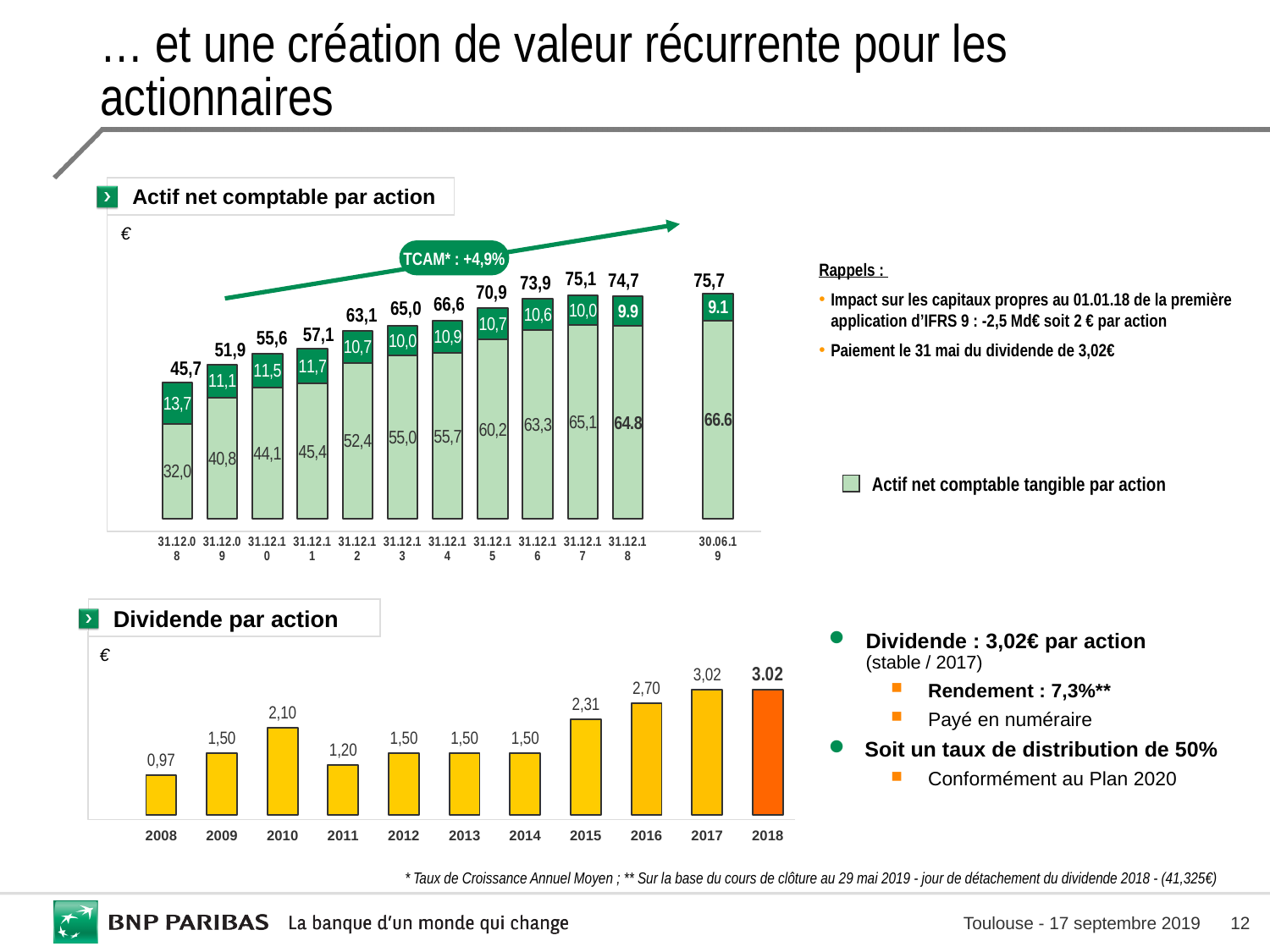
In the 'Actif net comptable par action' chart, which date has the highest total value? 30.06.19 In the 'Actif net comptable par action' chart, what is the tangible net asset value per share (lower segment) at 30.06.19? 66.6 What type of chart is the 'Dividende par action' chart? bar chart In the 'Actif net comptable par action' chart, what growth rate (TCAM) is annotated on the arrow? +4,9% In the 'Dividende par action' chart, is the dividend for 2011 larger or smaller than the dividend for 2012? smaller In the 'Actif net comptable par action' chart, what is the total value shown for 31.12.08? 45,7 In the 'Dividende par action' chart, what is the difference between the dividends for 2016 and 2015? 0,39 In the 'Actif net comptable par action' chart, how many bars are plotted? 12 In the 'Dividende par action' chart, which year has the lowest dividend? 2008 In the 'Dividende par action' chart, what is the dividend for 2010? 2,10 In the 'Dividende par action' chart, how many years are shown on the x axis? 11 In the 'Actif net comptable par action' chart, what is the difference between the total values at 31.12.18 and 31.12.17? 0,4